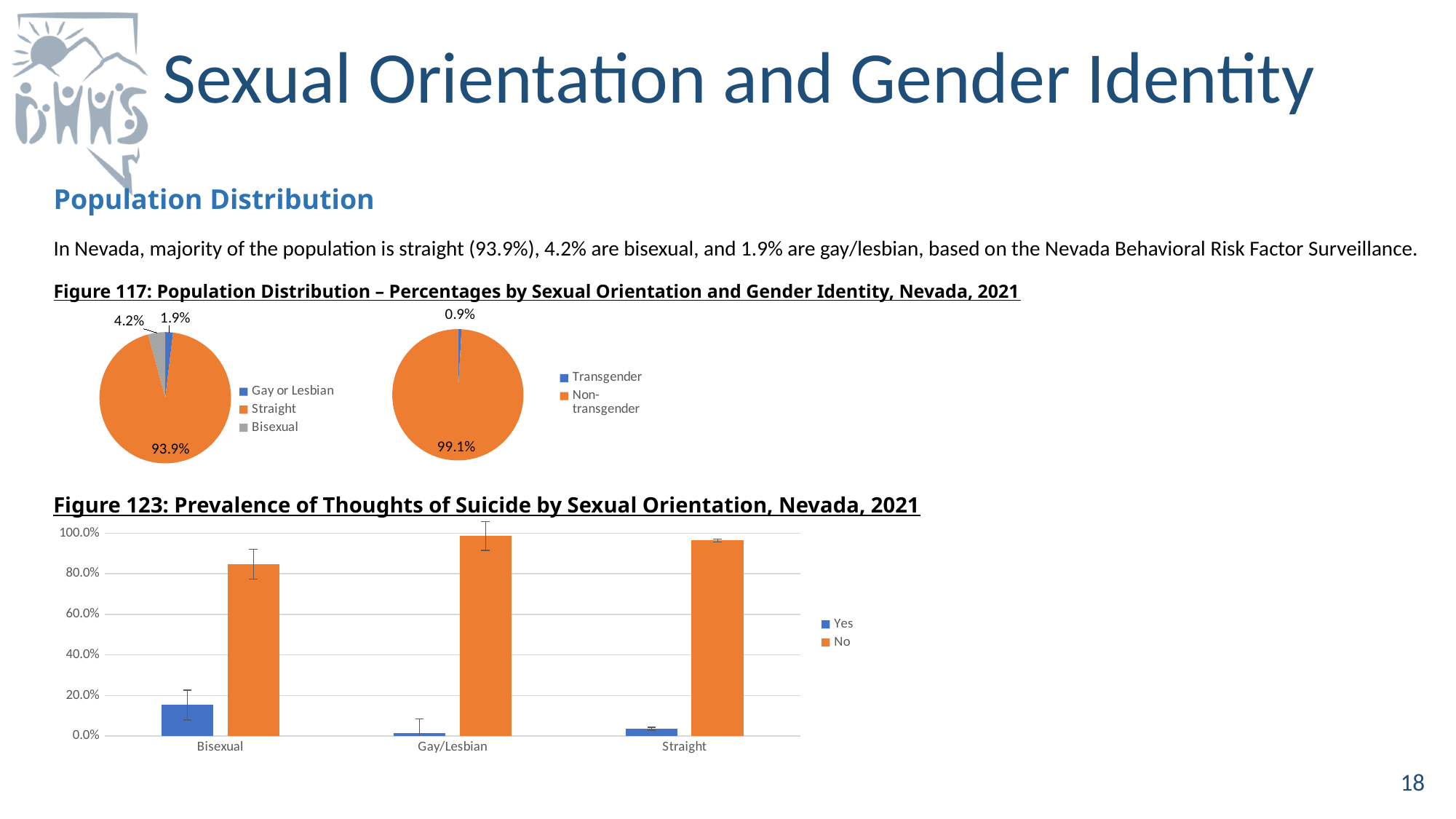
In Figure 123, is the No value for Bisexual greater or less than 80.0%? greater In the gender identity pie chart of Figure 117, what percentage is Transgender? 0.9% In the sexual orientation pie chart of Figure 117, which category has the smallest slice? Gay or Lesbian In the sexual orientation pie chart of Figure 117, what percentage is Bisexual? 4.2% In Figure 123, which sexual orientation category has the highest Yes value? Bisexual How many series does the legend of Figure 123 list? 2 How many slices does the sexual orientation pie chart in Figure 117 have? 3 What kind of chart is Figure 123? bar chart In the sexual orientation pie chart of Figure 117, how many percentage points larger is the Bisexual share than the Gay or Lesbian share? 2.3% In the gender identity pie chart of Figure 117, what percentage is Non-transgender? 99.1% In Figure 123, is the Yes value for Bisexual greater or less than 20.0%? less In the sexual orientation pie chart of Figure 117, what percentage of the population is Straight? 93.9%